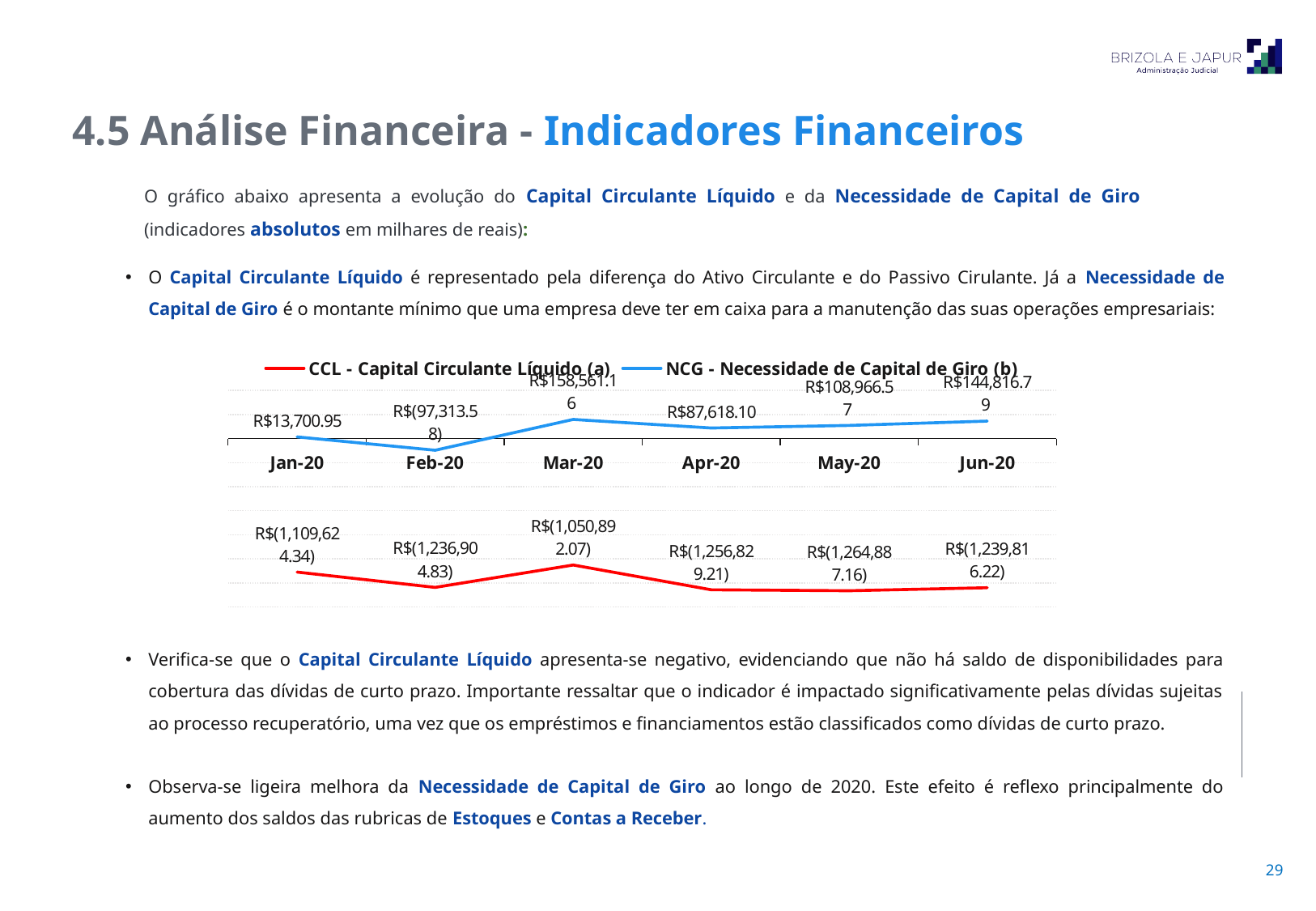
How many series does the chart legend list? 2 In which month is NCG - Necessidade de Capital de Giro (b) highest? Mar-20 What type of chart is shown on the slide? Line chart Which is larger for NCG - Necessidade de Capital de Giro (b): the value in Apr-20 or the value in Jun-20? Jun-20 What colour is the line for CCL - Capital Circulante Líquido (a)? Red What is the difference between the NCG - Necessidade de Capital de Giro (b) values in Jun-20 and Apr-20? R$57,198.69 What is the value of NCG - Necessidade de Capital de Giro (b) in Mar-20? R$158,561.16 What is the value of NCG - Necessidade de Capital de Giro (b) in Feb-20? R$(97,313.58) In which month is CCL - Capital Circulante Líquido (a) lowest? May-20 How many months are plotted on the x axis of the chart? 6 What is the value of CCL - Capital Circulante Líquido (a) in Jan-20? R$(1,109,624.34) Does NCG - Necessidade de Capital de Giro (b) rise or fall from Apr-20 to Jun-20? Rise